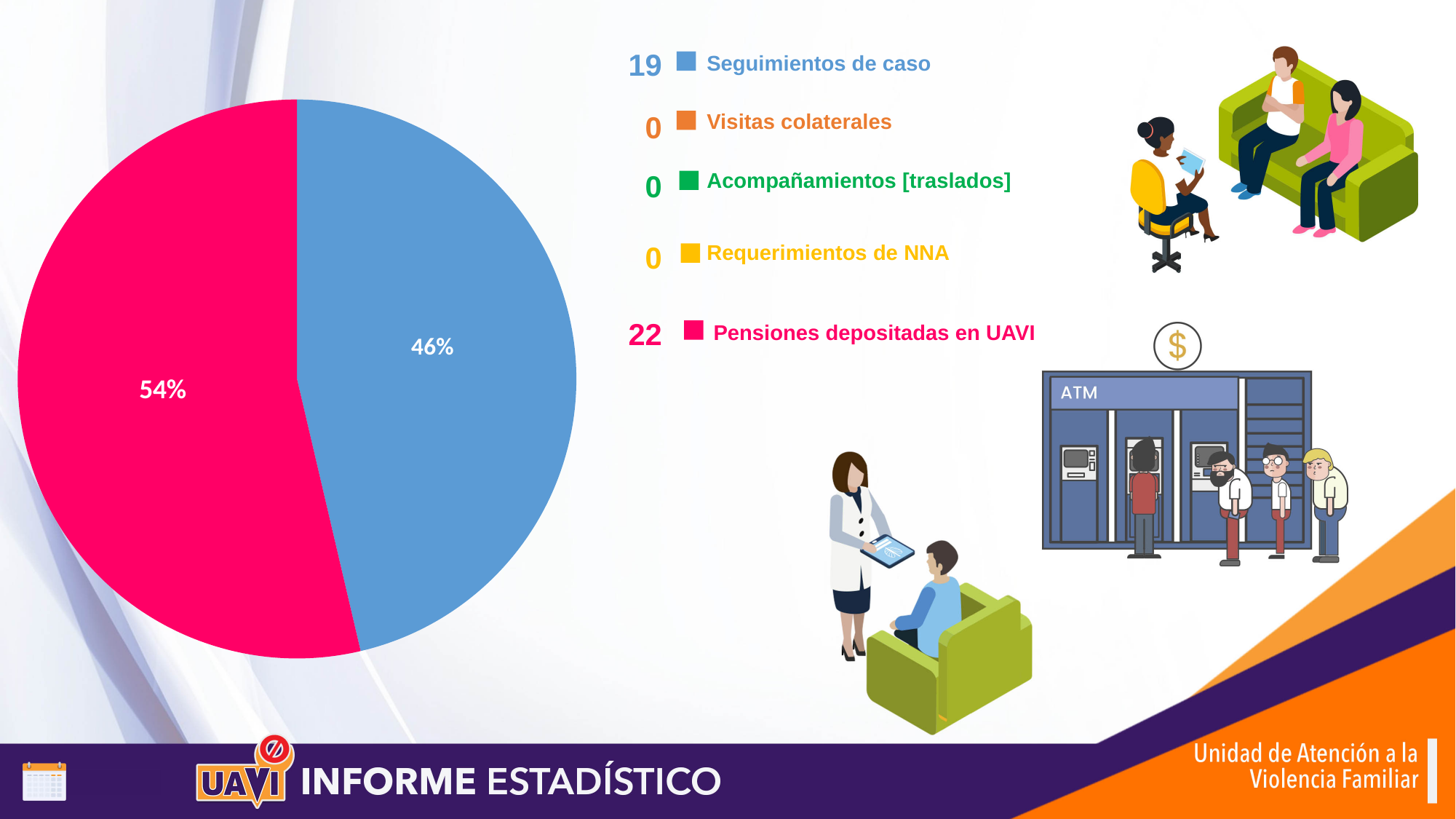
Which category has the highest count? Pensiones depositadas en UAVI What is the count shown for Visitas colaterales? 0 How many categories does the legend list? 5 What colour is the slice for Seguimientos de caso? blue What kind of chart is shown on the slide? pie chart Which is larger, the count for Seguimientos de caso or the count for Pensiones depositadas en UAVI? Pensiones depositadas en UAVI What is the difference between the count for Pensiones depositadas en UAVI and the count for Seguimientos de caso? 3 What is the count shown for Pensiones depositadas en UAVI in the legend? 22 What percentage share of the pie does the blue slice (Seguimientos de caso) represent? 46% How many categories in the legend have a count of 0? 3 What is the count shown for Seguimientos de caso in the legend? 19 What percentage share of the pie does the pink slice (Pensiones depositadas en UAVI) represent? 54%